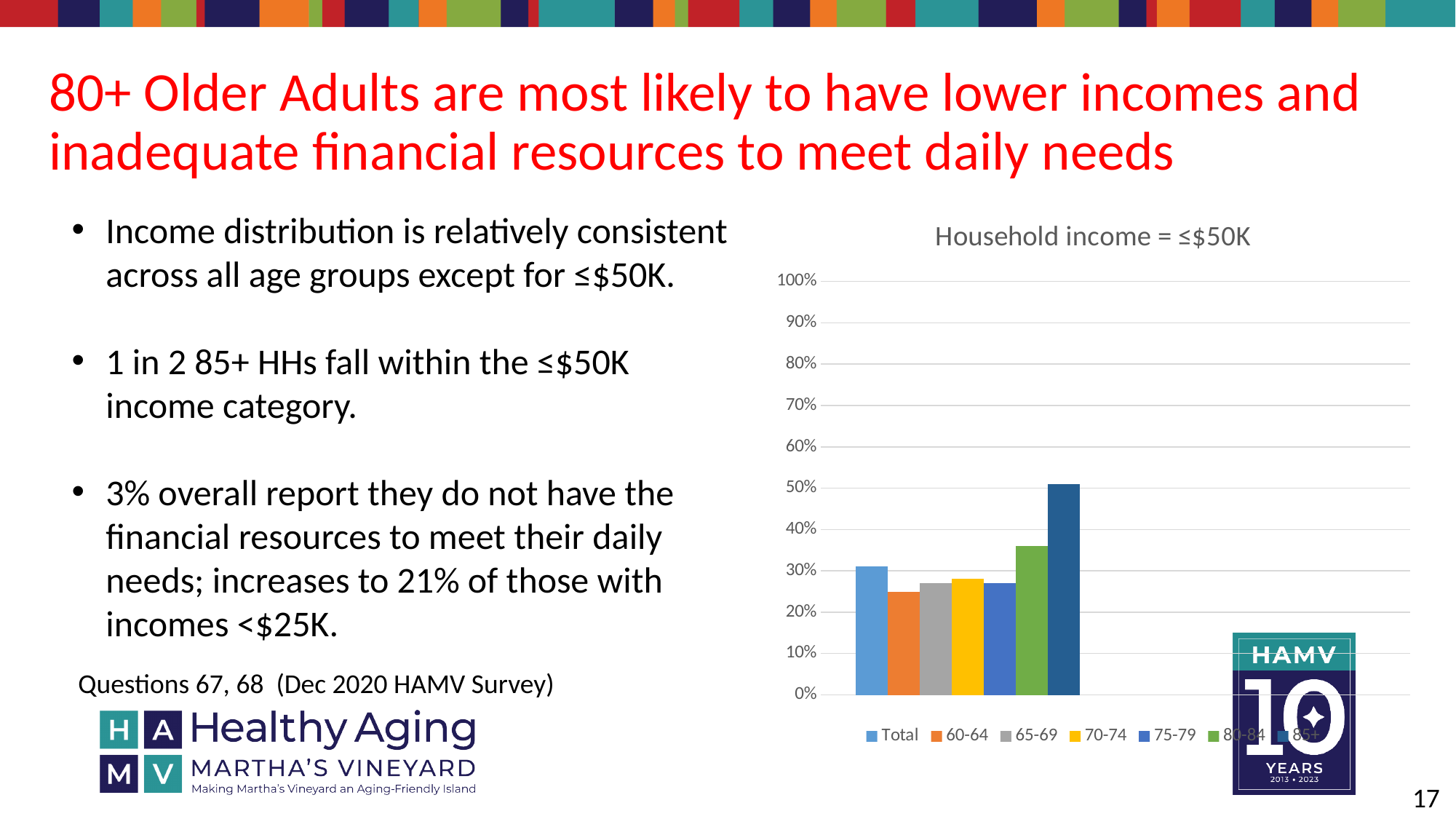
Is the value for Total greater or less than 40%? less How many series does the chart legend list? 7 Which is larger, the value for 85+ or the value for Total? 85+ Is the value for 60-64 greater or less than 30%? less Which series has the highest value in the chart? 85+ Which is larger, the value for 80-84 or the value for 70-74? 80-84 How many bars are plotted in the chart? 7 Is the value for 80-84 greater or less than 30%? greater What is the highest value shown on the vertical axis of the chart? 100% What is the title of the chart? Household income = ≤$50K What kind of chart is shown on the slide? bar chart